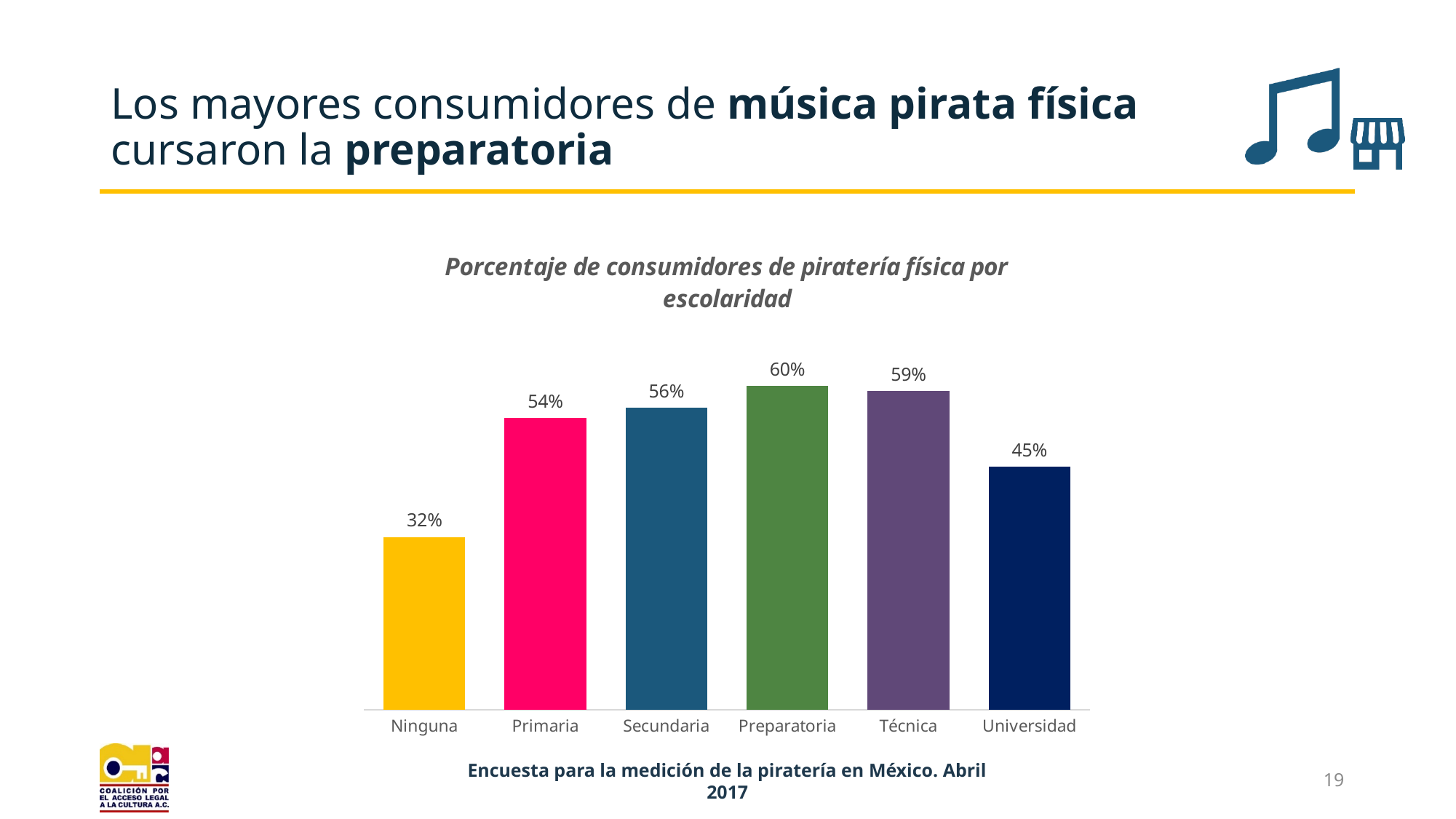
Which is larger, the value for Secundaria or the value for Universidad? Secundaria What is the difference between the values for Preparatoria and Ninguna? 28% What is the value for Preparatoria? 60% What is the value for Técnica? 59% What kind of chart is shown on the slide? Bar chart What is the value for Ninguna? 32% Which category has the lowest value? Ninguna What is the difference between the values for Secundaria and Primaria? 2% What is the title of the chart? Porcentaje de consumidores de piratería física por escolaridad What is the value for Universidad? 45% Which category has the highest value? Preparatoria How many categories are shown on the x axis? 6